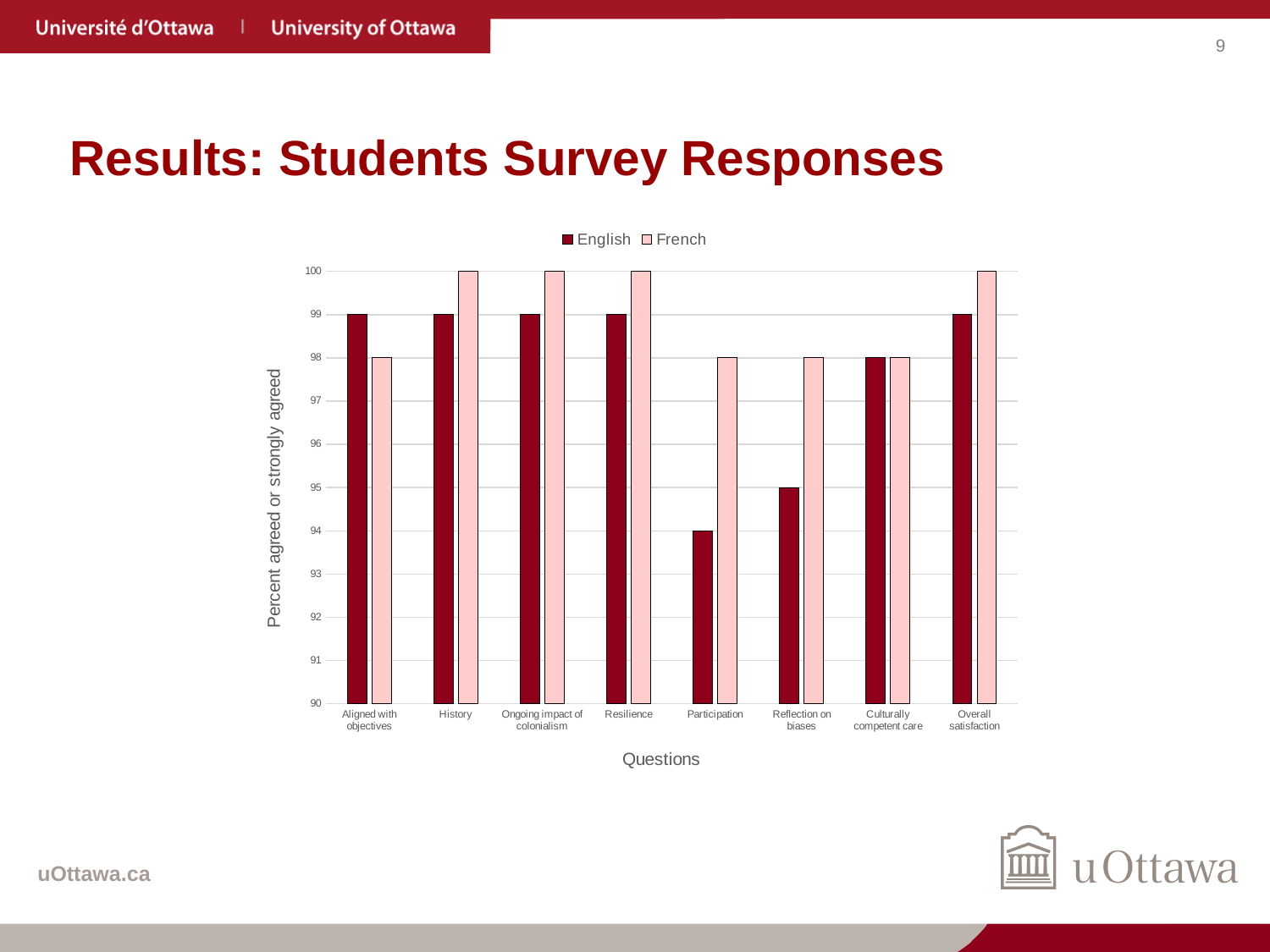
What is the difference between the French and English values for Participation? 4 Which category has the lowest French value? Aligned with objectives, Participation, Reflection on biases and Culturally competent care (tied at 98) What is the French value for History? 100 Which category has the lowest English value? Participation How many question categories are shown on the x axis? 8 What kind of chart is shown on the slide? bar chart What is the English value for Reflection on biases? 95 What is the label of the y axis? Percent agreed or strongly agreed How many series does the legend list? 2 What is the English value for Participation? 94 Is the English value for Participation greater or less than 95? less Which is larger for Aligned with objectives, the English value or the French value? English